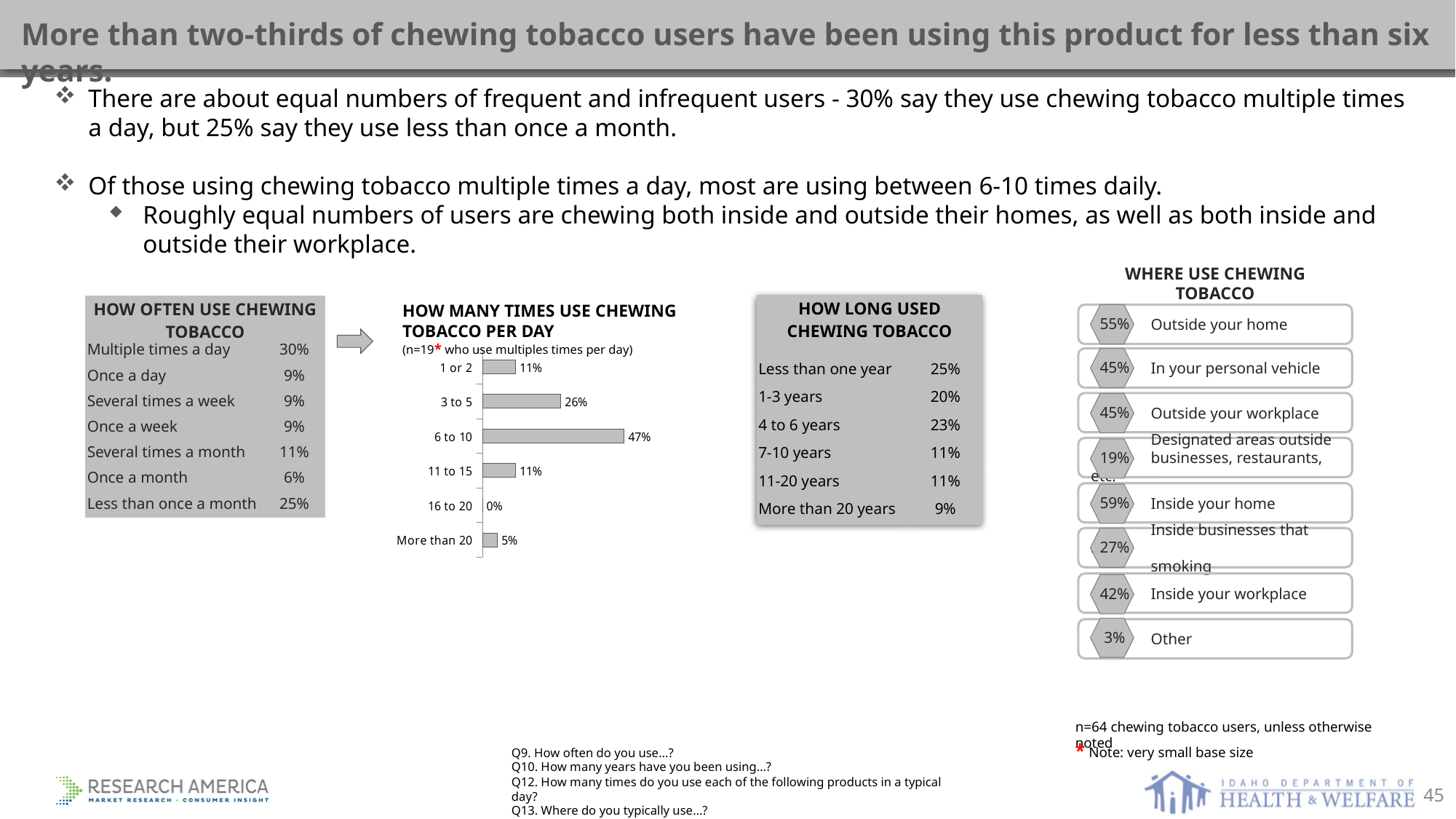
In the 'How many times use chewing tobacco per day' chart, what is the value for '3 to 5'? 26% In the 'How many times use chewing tobacco per day' chart, which category has the lowest value? 16 to 20 In the 'How many times use chewing tobacco per day' chart, what is the value for 'More than 20'? 5% In the 'How many times use chewing tobacco per day' chart, what is the value for '6 to 10'? 47% In the 'How many times use chewing tobacco per day' chart, which category has the highest value? 6 to 10 How many categories are shown in the 'How many times use chewing tobacco per day' chart? 6 What is the sample size noted under the title of the 'How many times use chewing tobacco per day' chart? n=19 In the 'How many times use chewing tobacco per day' chart, what is the difference between the values for '6 to 10' and '3 to 5'? 21% In the 'How many times use chewing tobacco per day' chart, which is larger: the value for '3 to 5' or the value for '11 to 15'? 3 to 5 In the 'How many times use chewing tobacco per day' chart, what is the difference between the values for '1 or 2' and 'More than 20'? 6% What kind of chart is the 'How many times use chewing tobacco per day' chart? Bar chart In the 'How many times use chewing tobacco per day' chart, what is the value for '16 to 20'? 0%